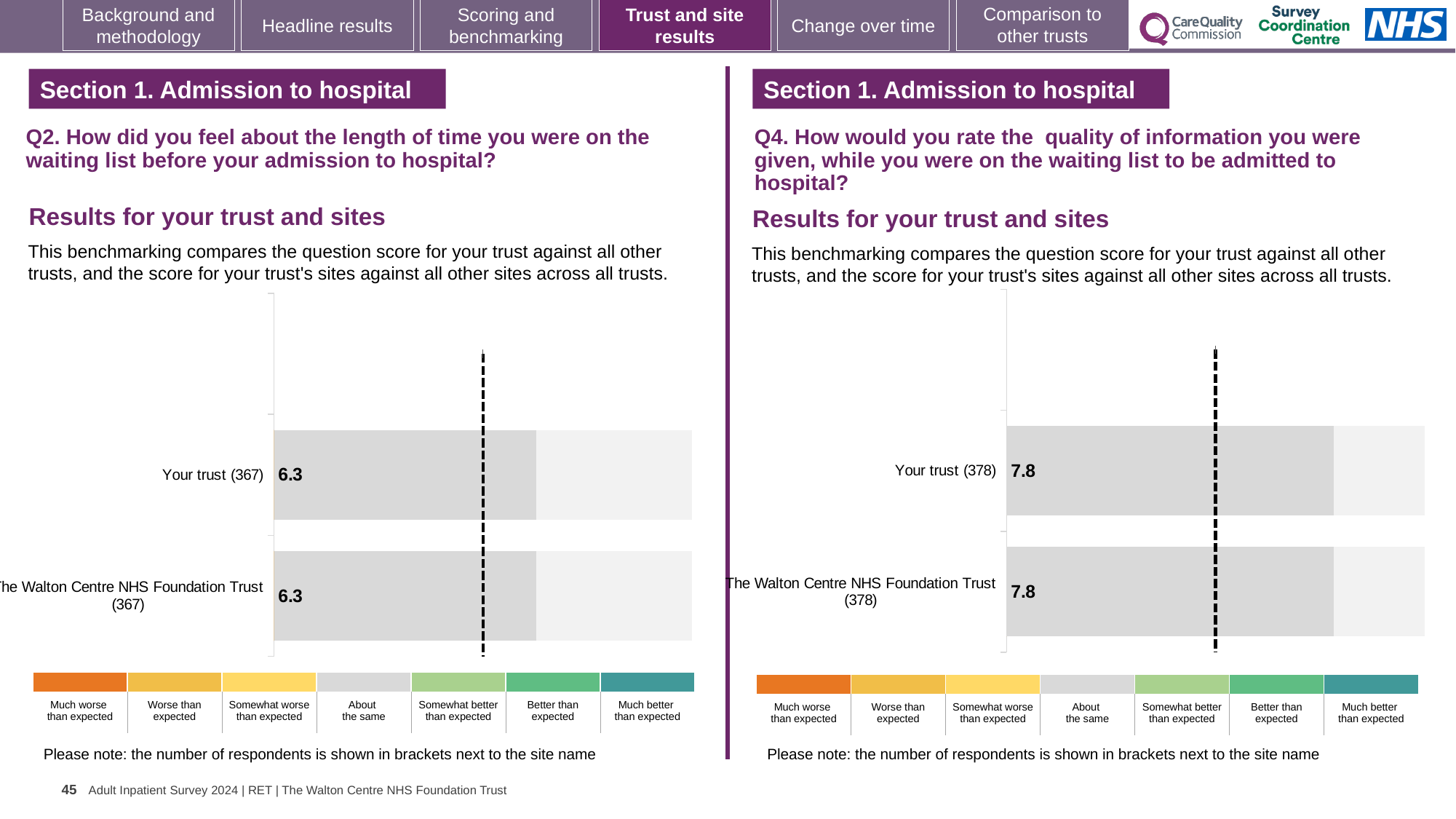
In the Q4 chart on the right, what is the score shown for The Walton Centre NHS Foundation Trust? 7.8 What type of chart is used for the Q2 results on the left? Bar chart In the Q2 chart on the left, what is the score shown for Your trust? 6.3 In the Q2 chart on the left, what is the score shown for The Walton Centre NHS Foundation Trust? 6.3 In the Q4 chart on the right, what is the score shown for Your trust? 7.8 How many bars are plotted in the Q2 chart on the left? 2 How many categories does the colour key below the Q4 chart on the right list? 7 In the Q4 chart on the right, what is the difference between the score for Your trust and the score for The Walton Centre NHS Foundation Trust? 0.0 In the Q2 chart on the left, what is the difference between the score for Your trust and the score for The Walton Centre NHS Foundation Trust? 0.0 How many bars are plotted in the Q4 chart on the right? 2 In the Q2 chart on the left, how many respondents are shown in brackets next to Your trust? 367 In the Q4 chart on the right, how many respondents are shown in brackets next to The Walton Centre NHS Foundation Trust? 378